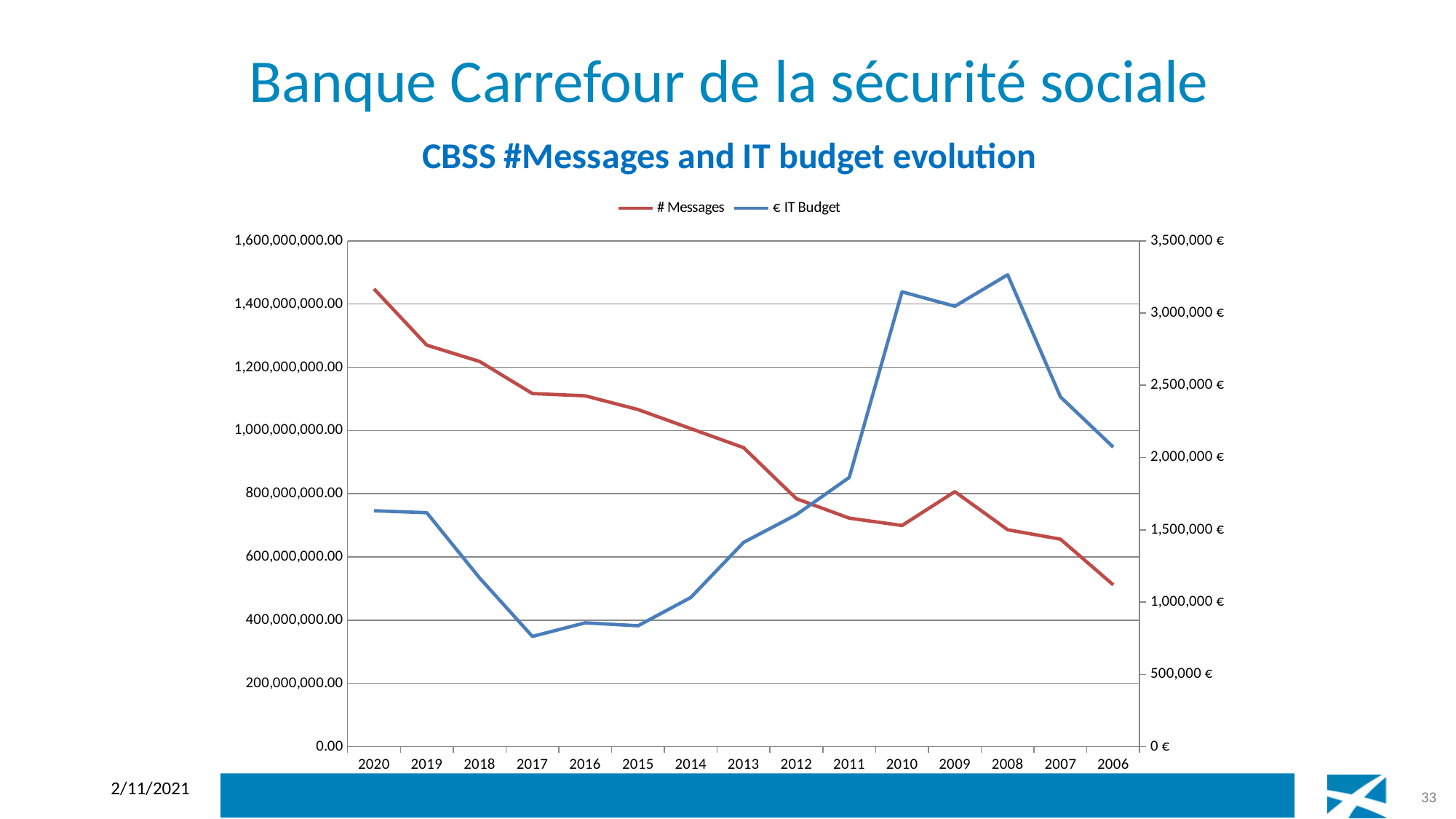
Which colour is used for the # Messages series? Red What is the title of the chart? CBSS #Messages and IT budget evolution Which year has the larger € IT Budget value, 2008 or 2006? 2008 How many series does the legend list? 2 In which year is the € IT Budget series lowest? 2017 In which year is the € IT Budget series highest? 2008 What kind of chart is shown on the slide? Line chart In which year is the # Messages series highest? 2020 In which year is the # Messages series lowest? 2006 Is the # Messages value for 2020 greater or less than 1,200,000,000.00? greater Is the € IT Budget value for 2017 greater or less than 1,000,000 €? less How many years are shown on the x axis? 15